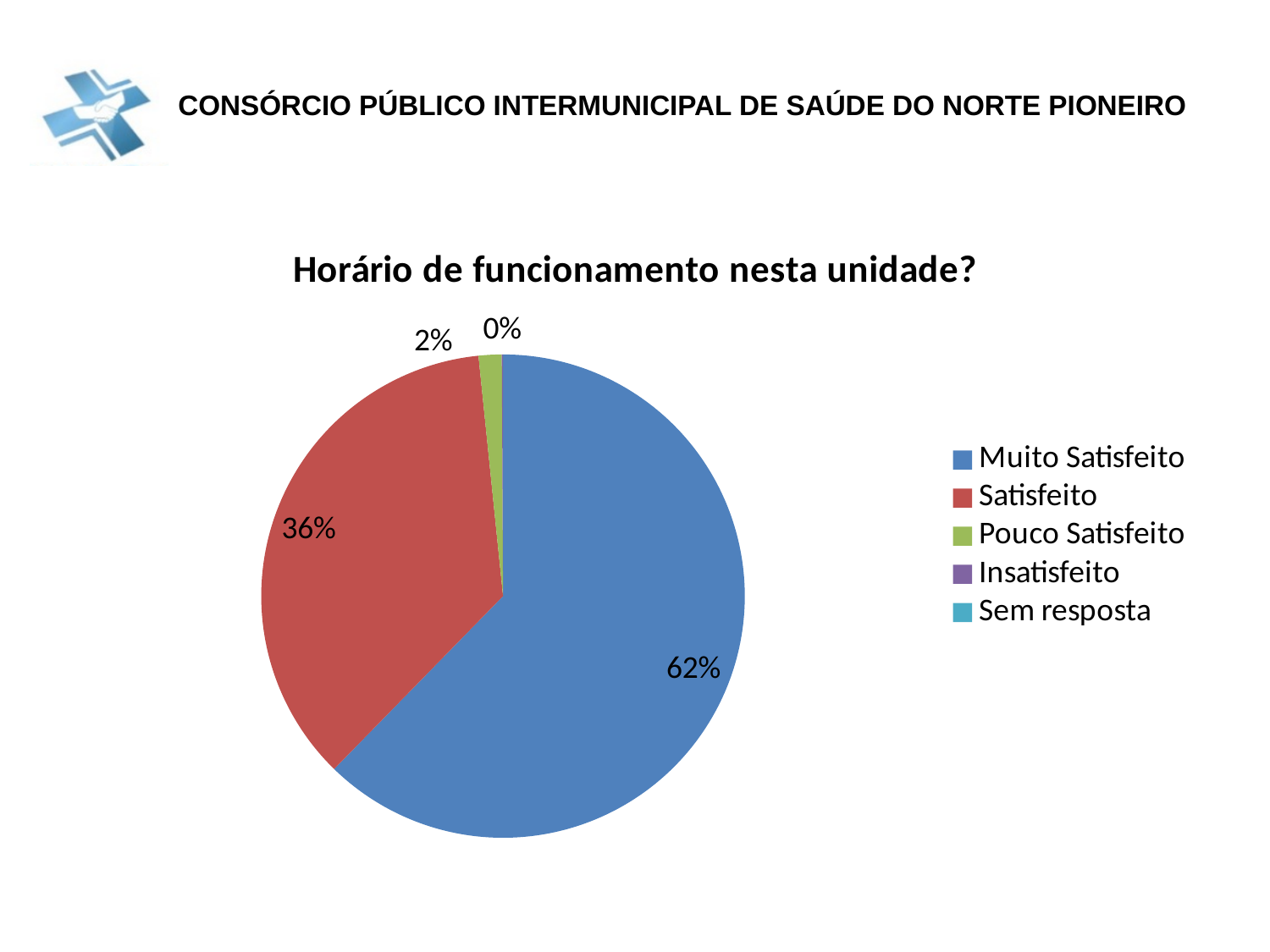
Which category has the largest slice of the pie? Muito Satisfeito How many categories does the legend list? 5 Is the share for Muito Satisfeito greater or less than 50%? greater What share of the pie is labelled for Muito Satisfeito? 62% What is the title of the chart? Horário de funcionamento nesta unidade? What colour is the slice for Muito Satisfeito? blue Which is larger, the slice for Satisfeito or the slice for Pouco Satisfeito? Satisfeito What kind of chart is shown on the slide? pie chart What is the difference in percentage points between the Satisfeito slice and the Pouco Satisfeito slice? 34% What is the difference in percentage points between the Muito Satisfeito slice and the Satisfeito slice? 26% What share of the pie is labelled for Satisfeito? 36% What share of the pie is labelled for Pouco Satisfeito? 2%